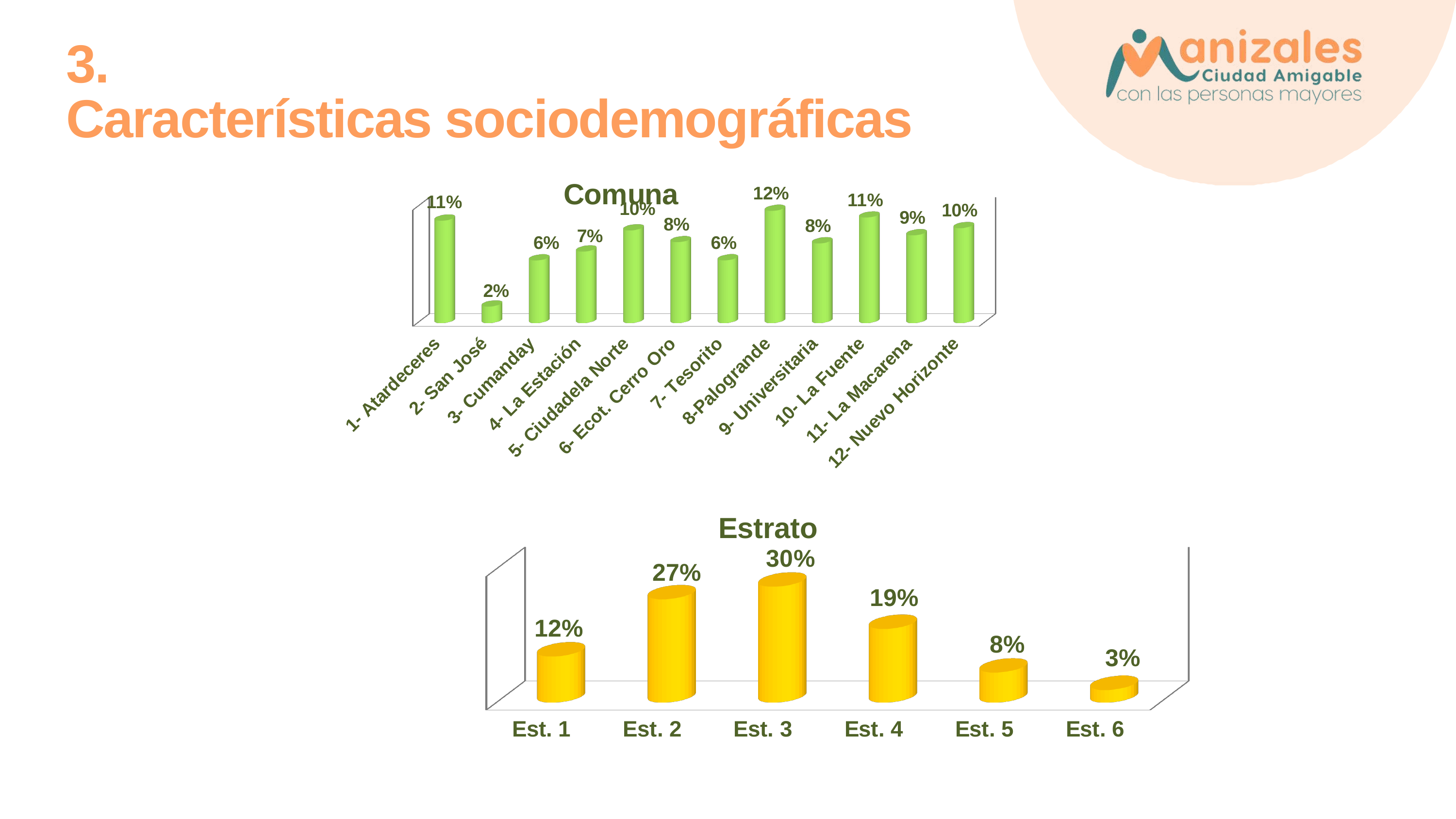
What kind of chart is the Estrato chart? Bar chart In the Estrato chart, which is larger, Est. 2 or Est. 4? Est. 2 In the Comuna chart, which comuna has the highest value? 8-Palogrande In the Comuna chart, how many comunas are shown? 12 In the Comuna chart, what is the value for 2- San José? 2% In the Comuna chart, what is the value for 8-Palogrande? 12% In the Estrato chart, which estrato has the lowest value? Est. 6 In the Estrato chart, what is the value for Est. 4? 19% In the Comuna chart, what is the difference between 1- Atardeceres and 3- Cumanday? 5% In the Estrato chart, what is the difference between Est. 3 and Est. 1? 18% In the Estrato chart, which estrato has the highest value? Est. 3 In the Comuna chart, which comuna has the lowest value? 2- San José